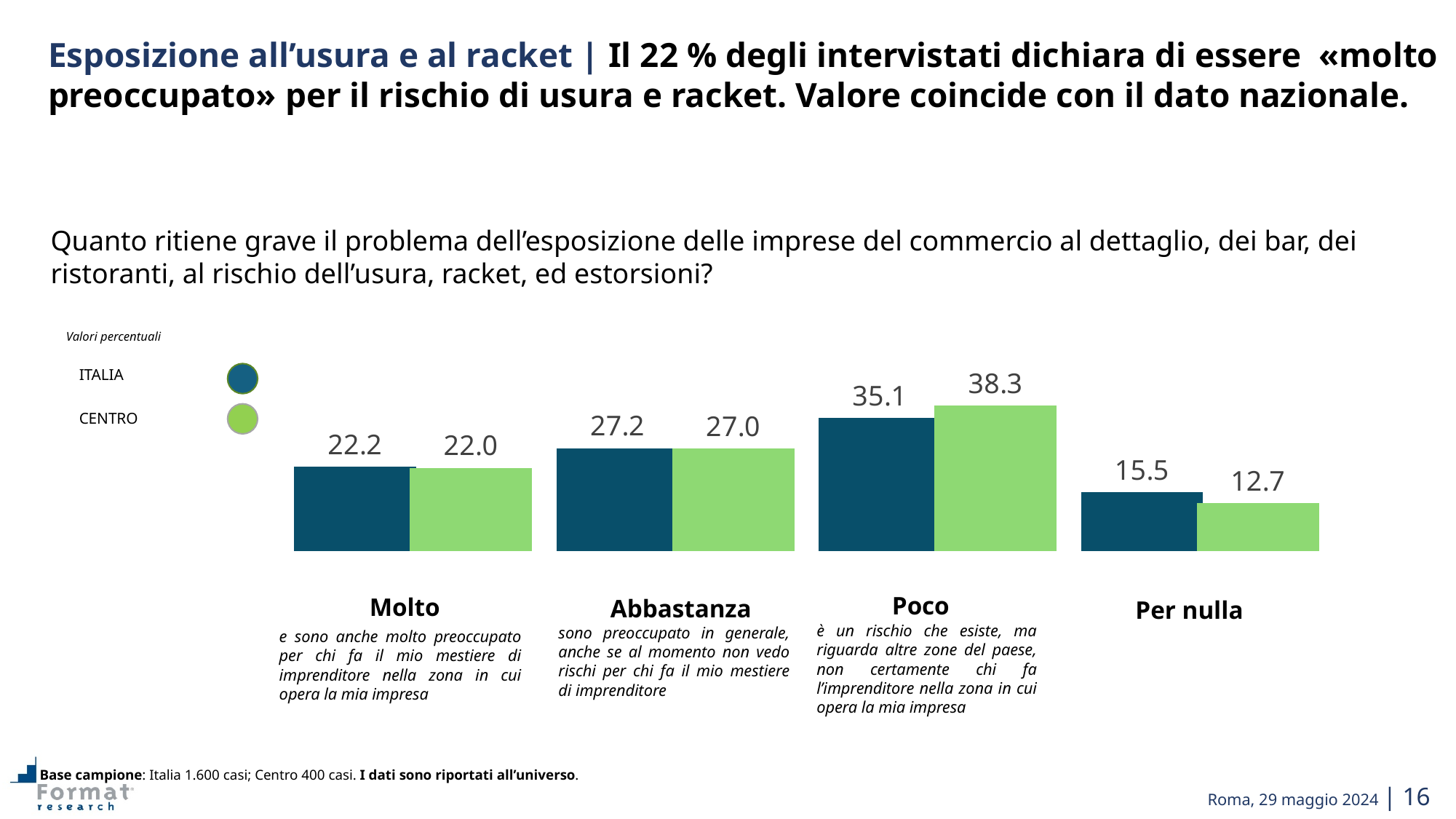
What is the difference between the CENTRO and ITALIA values for 'Poco'? 3.2 What kind of chart is shown on the slide? Bar chart Which category has the highest CENTRO value? Poco What is the CENTRO value for the 'Poco' category? 38.3 What is the ITALIA value for the 'Molto' category? 22.2 What is the difference between the ITALIA and CENTRO values for 'Per nulla'? 2.8 For 'Per nulla', which is larger: the ITALIA value or the CENTRO value? ITALIA How many categories are shown on the x axis of the chart? 4 How many series does the legend list? 2 What is the CENTRO value for the 'Per nulla' category? 12.7 What is the ITALIA value for the 'Abbastanza' category? 27.2 Which category has the lowest ITALIA value? Per nulla